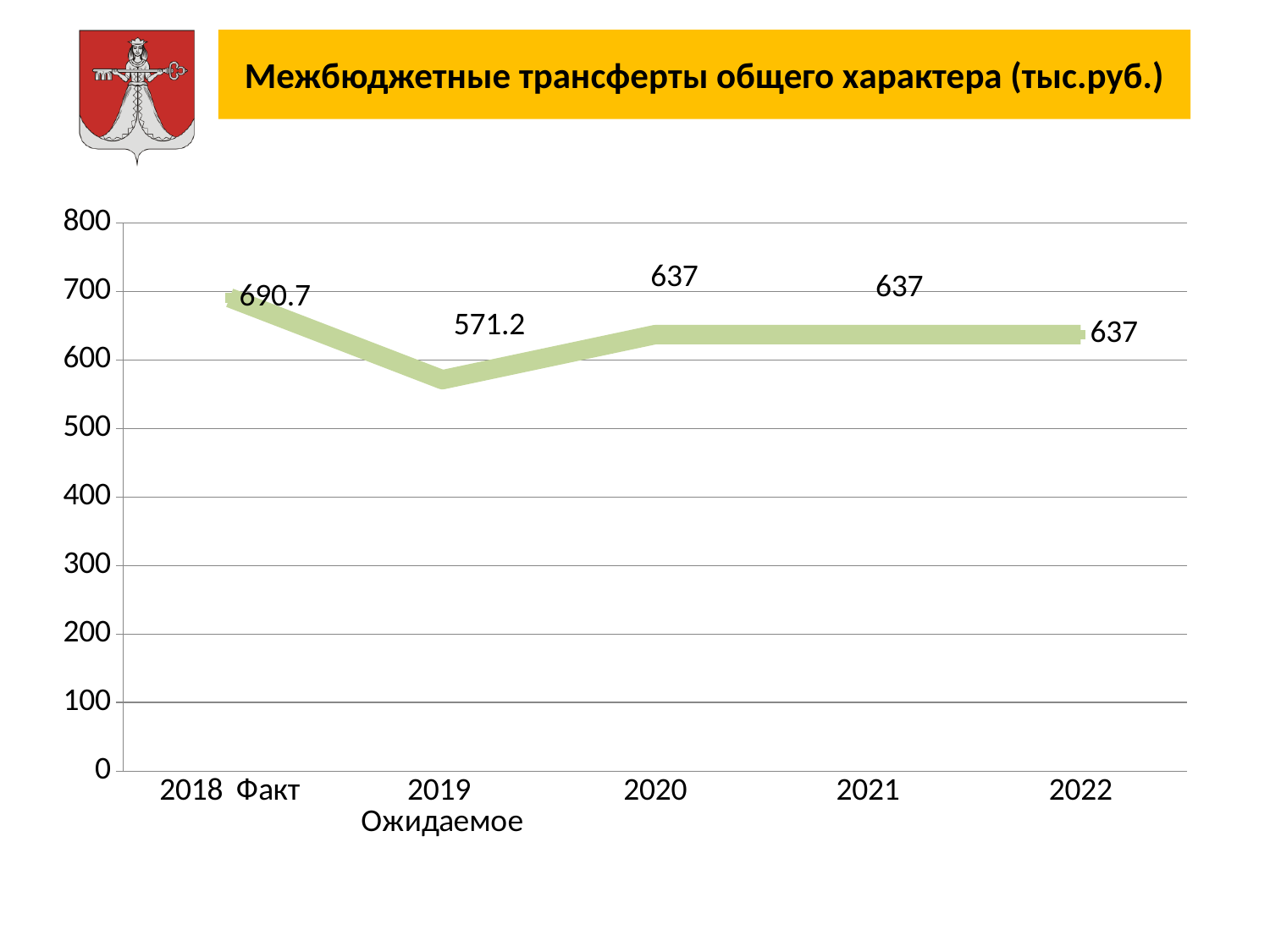
What is the difference between the values for 2018 Факт and 2019 Ожидаемое? 119.5 Which is larger, the value for 2018 Факт or the value for 2021? 2018 Факт What is the value for 2019 Ожидаемое? 571.2 What is the value for 2020? 637 What is the title of the chart? Межбюджетные трансферты общего характера (тыс.руб.) How many categories are shown on the x axis? 5 Which category has the lowest value? 2019 Ожидаемое What kind of chart is shown on the slide? line chart What is the difference between the values for 2020 and 2019 Ожидаемое? 65.8 Which category has the highest value? 2018 Факт What is the value for 2018 Факт? 690.7 What is the value for 2022? 637